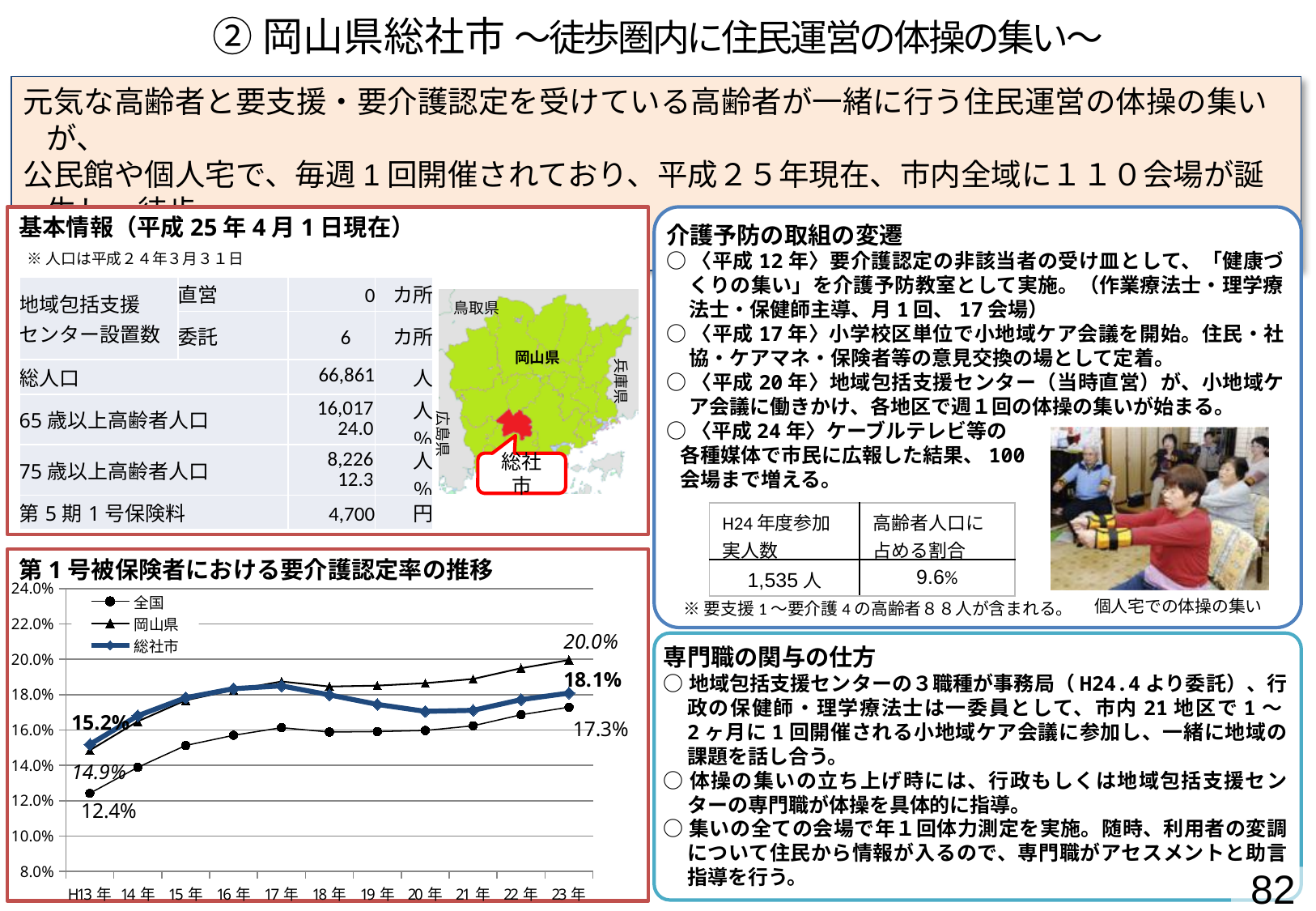
In the 要介護認定率の推移 chart, which series has the lowest value in H13年? 全国 In the 要介護認定率の推移 chart, what is the difference between the 岡山県 and 総社市 values in 23年? 1.9% In the 要介護認定率の推移 chart, what is the value for 全国 in 23年? 17.3% How many series does the legend of the 要介護認定率の推移 chart list? 3 What kind of chart is shown under the title 第1号被保険者における要介護認定率の推移? line chart How many years are plotted along the x axis of the 要介護認定率の推移 chart? 11 In the 要介護認定率の推移 chart, what is the value for 全国 in H13年? 12.4% In the 要介護認定率の推移 chart, does the 全国 series rise or fall from H13年 to 23年? rise In the 要介護認定率の推移 chart, what is the value for 岡山県 in 23年? 20.0% In the 要介護認定率の推移 chart, which series has the highest value in 23年? 岡山県 In the 要介護認定率の推移 chart, what is the value for 総社市 in H13年? 15.2% In the 要介護認定率の推移 chart, is the 全国 value in 17年 greater or less than 18.0%? less